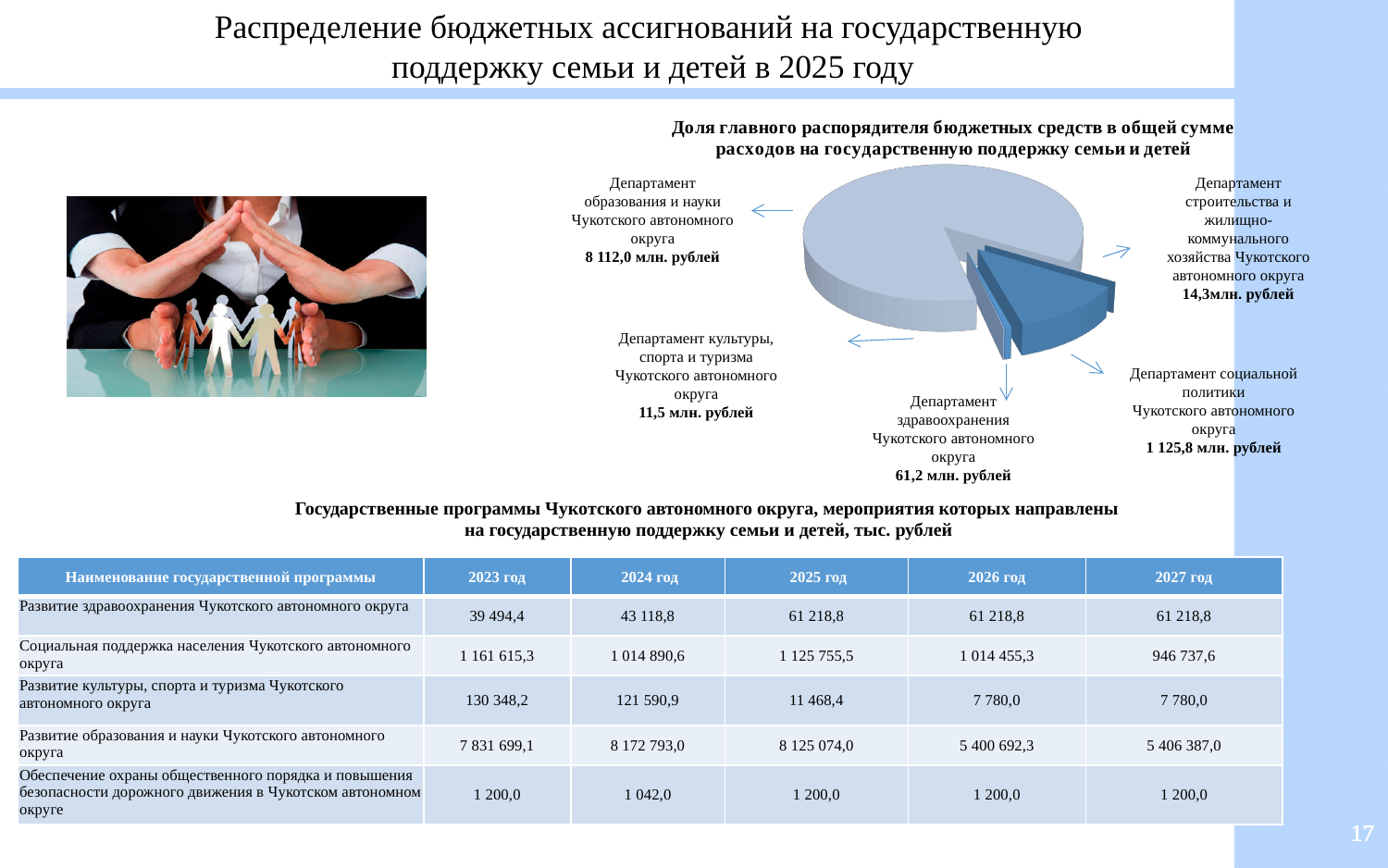
How many slices (departments) does the pie chart have? 5 Which department has the smallest value in the pie chart? Департамент культуры, спорта и туризма Чукотского автономного округа Which department has the largest value in the pie chart? Департамент образования и науки Чукотского автономного округа What is the value shown for Департамент здравоохранения Чукотского автономного округа in the pie chart? 61,2 млн. рублей What is the title of the pie chart? Доля главного распорядителя бюджетных средств в общей сумме расходов на государственную поддержку семьи и детей What kind of chart is shown on the slide? Pie chart What is the value shown for Департамент образования и науки Чукотского автономного округа in the pie chart? 8 112,0 млн. рублей What is the value shown for Департамент социальной политики Чукотского автономного округа in the pie chart? 1 125,8 млн. рублей What is the value shown for Департамент культуры, спорта и туризма Чукотского автономного округа in the pie chart? 11,5 млн. рублей By how much does the value for Департамент социальной политики exceed the value for Департамент здравоохранения in the pie chart? 1 064,6 млн. рублей Which is larger in the pie chart: the value for Департамент здравоохранения or for Департамент строительства и жилищно-коммунального хозяйства? Департамент здравоохранения What is the value shown for Департамент строительства и жилищно-коммунального хозяйства Чукотского автономного округа in the pie chart? 14,3 млн. рублей